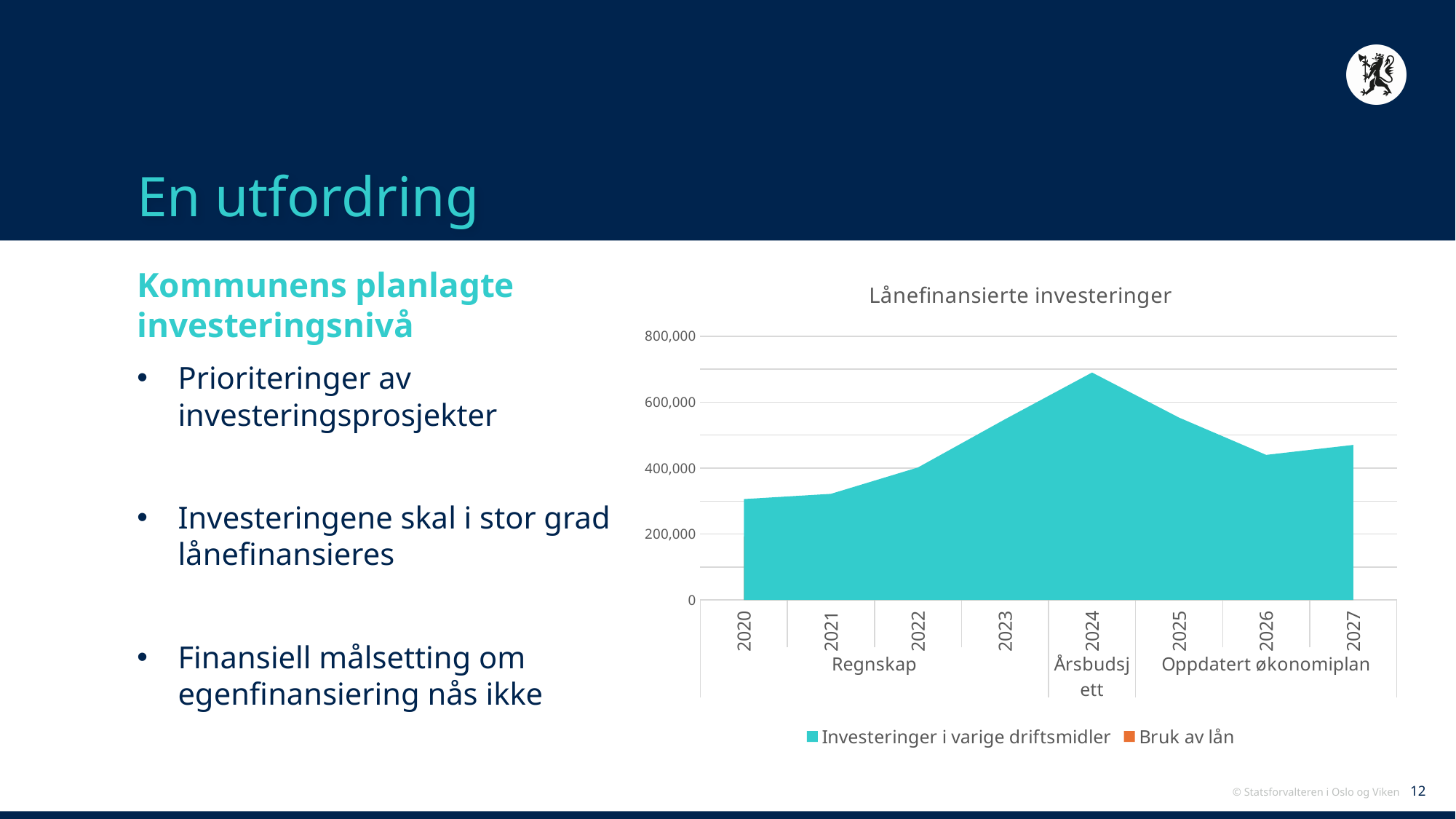
How many years are shown on the x axis of the chart? 8 Which year has the lowest value for Investeringer i varige driftsmidler? 2020 What is the name of the second series listed in the chart legend? Bruk av lån Which year has the highest value for Investeringer i varige driftsmidler? 2024 Do the values for Investeringer i varige driftsmidler rise or fall from 2020 to 2024? Rise Is the value for Investeringer i varige driftsmidler in 2023 greater or less than 400,000? greater What is the title of the chart? Lånefinansierte investeringer How many series does the chart legend list? 2 What kind of chart is shown on the slide? Area chart Which year has the larger value for Investeringer i varige driftsmidler, 2025 or 2026? 2025 Is the value for Investeringer i varige driftsmidler in 2024 greater or less than 600,000? greater Is the value for Investeringer i varige driftsmidler in 2020 greater or less than 400,000? less